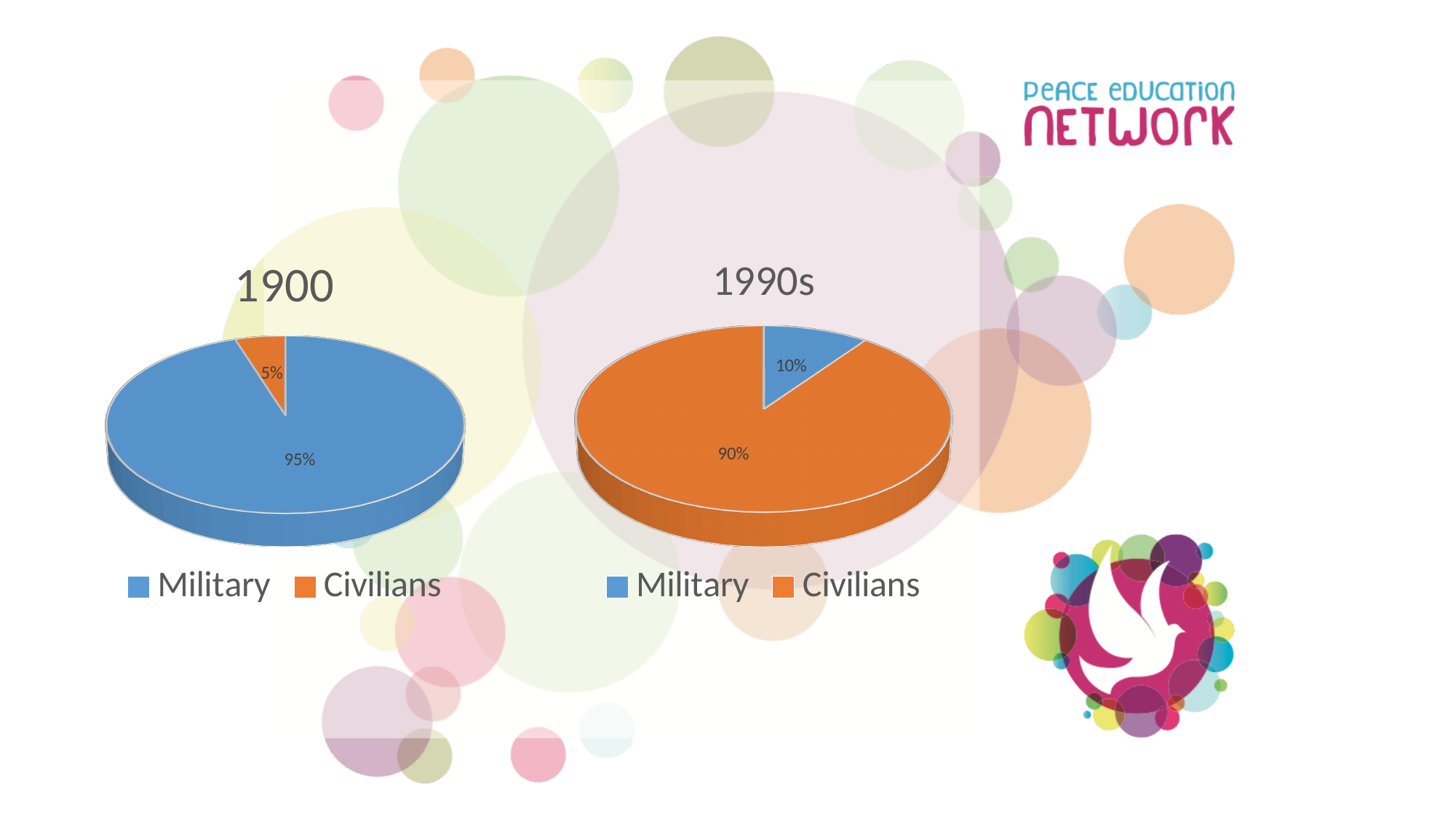
In the 1900 pie chart, what share is Civilians? 5% How many categories does the 1990s pie chart show? 2 In the 1990s pie chart, which category has the smallest slice? Military In the 1900 pie chart, what colour represents Civilians? Orange In the 1990s pie chart, what share is Military? 10% In the 1990s pie chart, what is the difference between the Civilians and Military shares? 80% In the 1900 pie chart, which category has the largest slice? Military In the 1990s pie chart, what share is Civilians? 90% In the 1900 pie chart, what share is Military? 95% In the 1900 pie chart, what is the difference between the Military and Civilians shares? 90% Which is larger: the Military share in the 1900 chart or the Military share in the 1990s chart? 1900 What type of chart is used for the 1900 data? Pie chart